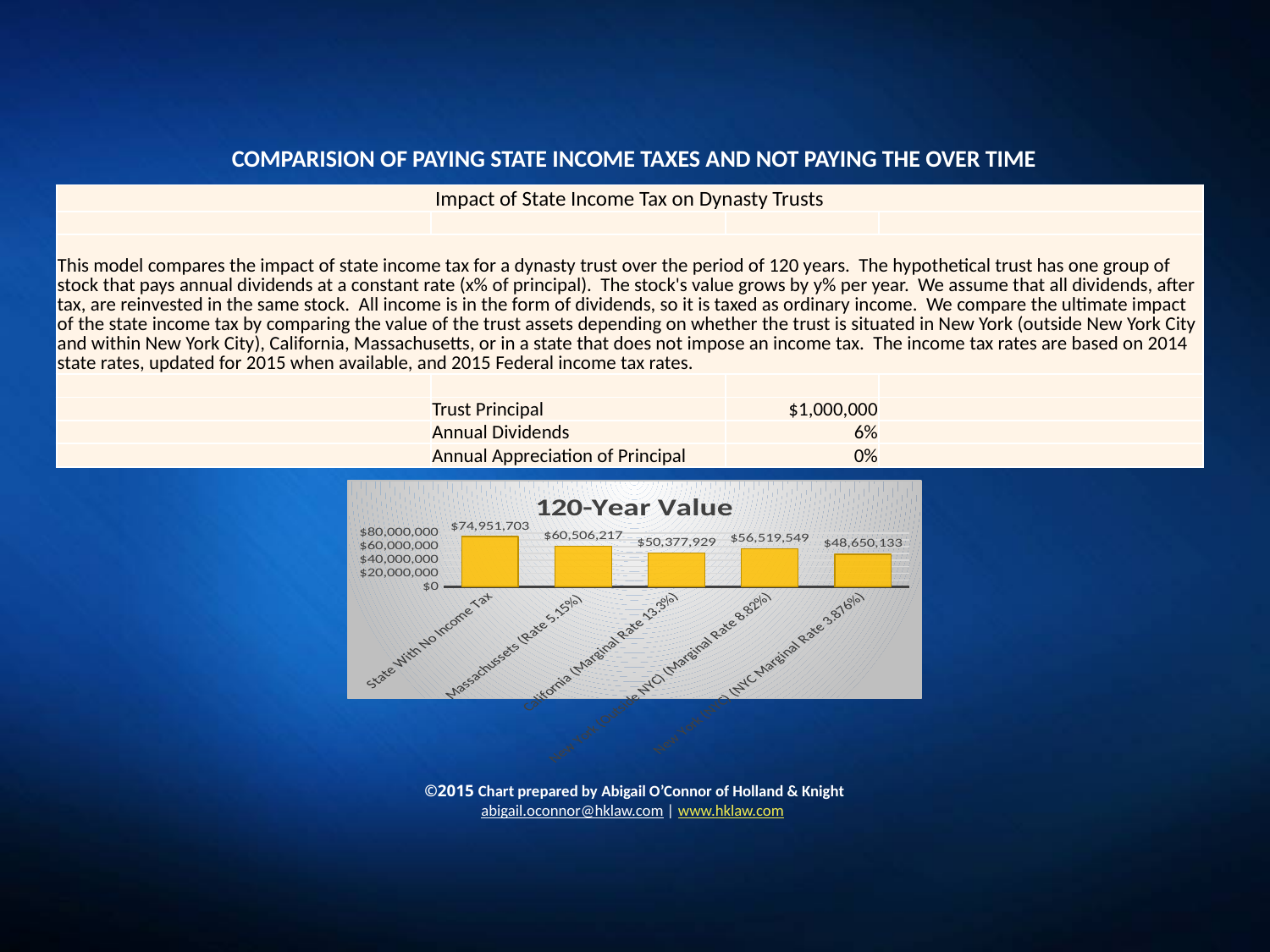
What is the difference between the 120-Year Value for Massachusetts (Rate 5.15%) and for California (Marginal Rate 13.3%)? $10,128,288 What is the 120-Year Value for State With No Income Tax? $74,951,703 Which category has the lowest 120-Year Value? New York (NYC) (NYC Marginal Rate 3.876%) What kind of chart is the 120-Year Value chart? Bar chart Which category has the highest 120-Year Value? State With No Income Tax What is the title of the chart on the slide? 120-Year Value How many bars are shown in the 120-Year Value chart? 5 What is the 120-Year Value for Massachusetts (Rate 5.15%)? $60,506,217 Which has a larger 120-Year Value, California (Marginal Rate 13.3%) or the category labelled with Marginal Rate 8.82%? The category labelled with Marginal Rate 8.82% (New York outside NYC) What is the 120-Year Value for California (Marginal Rate 13.3%)? $50,377,929 What is the 120-Year Value for the category labelled with NYC Marginal Rate 3.876%? $48,650,133 What is the difference between the 120-Year Value for State With No Income Tax and for Massachusetts (Rate 5.15%)? $14,445,486